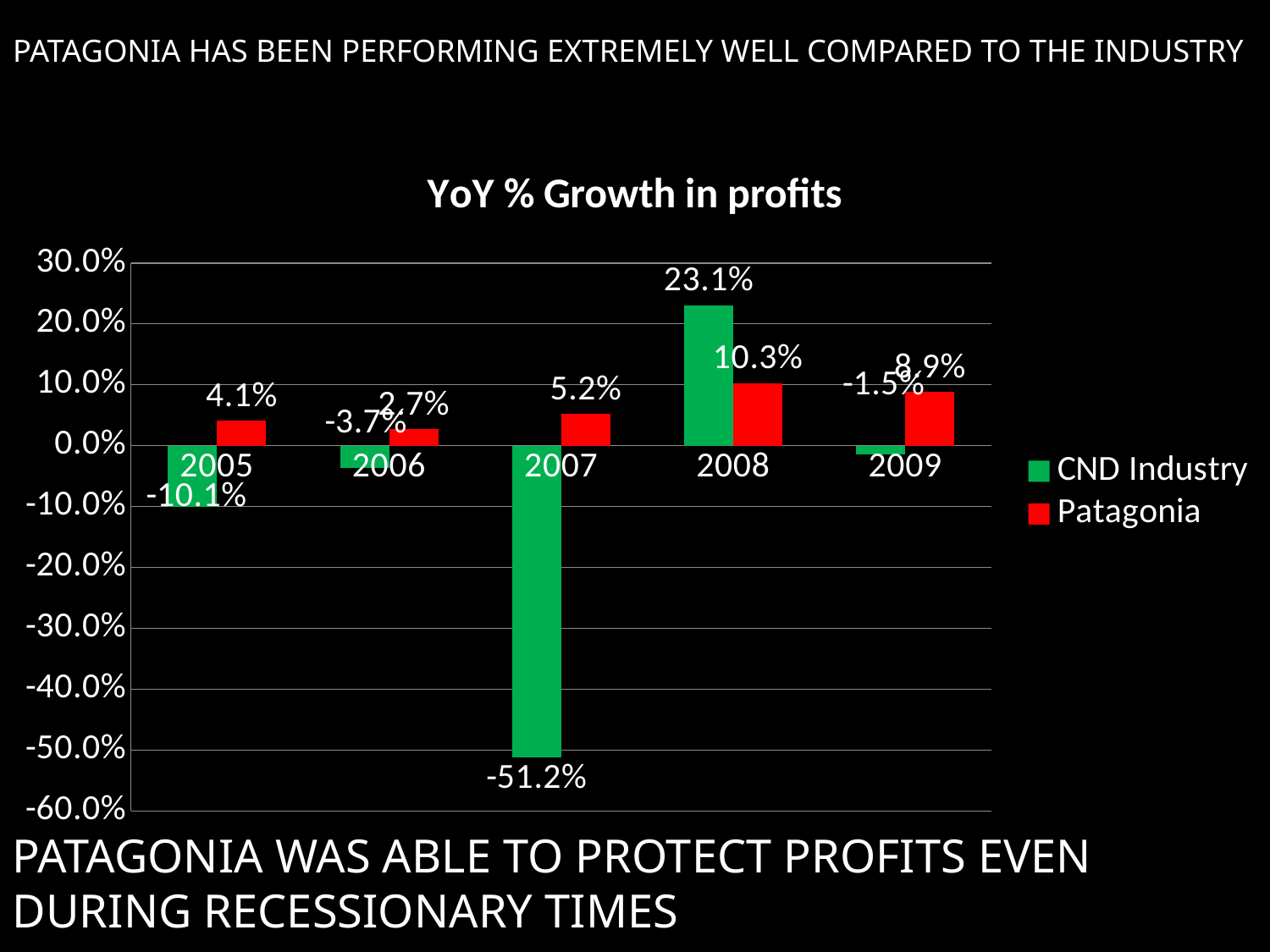
What kind of chart is shown on the slide? Bar chart What is the YoY % growth in profits for Patagonia in 2008? 10.3% In which year did CND Industry have its lowest YoY % growth in profits? 2007 In which year did Patagonia have its highest YoY % growth in profits? 2008 In 2005, which had the higher YoY % growth in profits, CND Industry or Patagonia? Patagonia How many series does the legend list? 2 What is the title of the chart? YoY % Growth in profits What is the YoY % growth in profits for CND Industry in 2009? -1.5% How many years are shown on the x axis of the chart? 5 What is the YoY % growth in profits for CND Industry in 2007? -51.2% From 2006 to 2008, does Patagonia's YoY % growth in profits rise or fall? Rise In 2008, how many percentage points higher is CND Industry's growth than Patagonia's? 12.8 percentage points